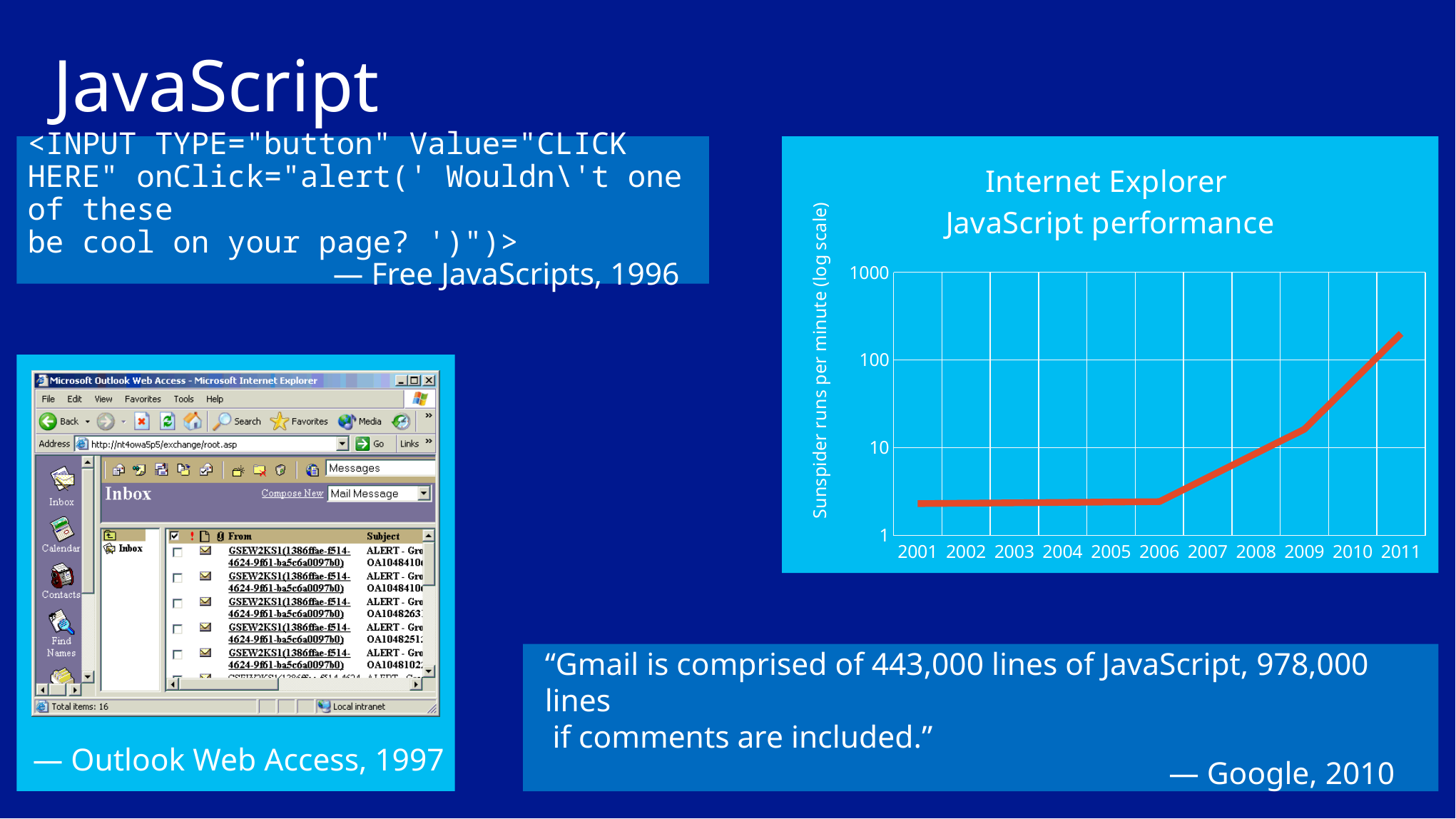
In the Internet Explorer JavaScript performance chart, is the value for 2001 greater or less than 10? less In the Internet Explorer JavaScript performance chart, is the value for 2006 greater or less than 10? less In the Internet Explorer JavaScript performance chart, do the values rise or fall from 2006 to 2011? rise How many years are shown on the x axis of the Internet Explorer JavaScript performance chart? 11 What is the y-axis label of the Internet Explorer JavaScript performance chart? Sunspider runs per minute (log scale) In the Internet Explorer JavaScript performance chart, which is larger, the value for 2011 or the value for 2001? 2011 In the Internet Explorer JavaScript performance chart, which year has the highest value? 2011 What kind of chart is the "Internet Explorer JavaScript performance" chart? line chart In the Internet Explorer JavaScript performance chart, is the value for 2010 greater or less than 100? less What is the title of the chart on the slide? Internet Explorer JavaScript performance